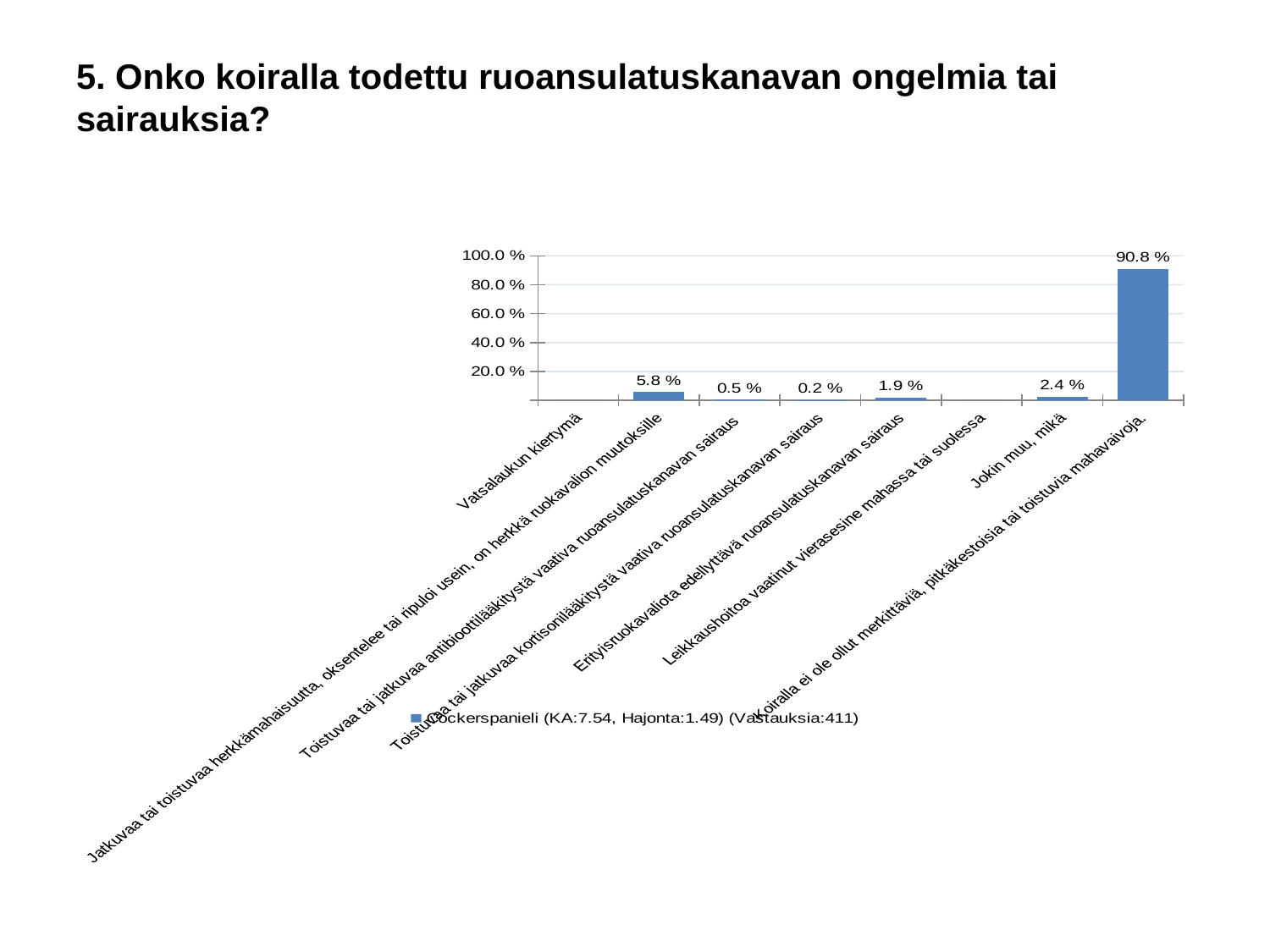
What series name does the legend show? Cockerspanieli (KA:7.54, Hajonta:1.49) (Vastauksia:411) What kind of chart is shown on the slide? bar chart What is the difference between the values for "Jokin muu, mikä" and "Erityisruokavaliota edellyttävä ruoansulatuskanavan sairaus"? 0.5 % What is the value for "Toistuvaa tai jatkuvaa kortisonilääkitystä vaativa ruoansulatuskanavan sairaus"? 0.2 % What is the value for "Jokin muu, mikä"? 2.4 % What is the value for "Koiralla ei ole ollut merkittäviä, pitkäkestoisia tai toistuvia mahavaivoja."? 90.8 % Which is larger, the value for "Jokin muu, mikä" or the value for "Toistuvaa tai jatkuvaa antibioottilääkitystä vaativa ruoansulatuskanavan sairaus"? Jokin muu, mikä Is the value for "Koiralla ei ole ollut merkittäviä, pitkäkestoisia tai toistuvia mahavaivoja." greater or less than 80.0 %? greater Which category has the highest value? Koiralla ei ole ollut merkittäviä, pitkäkestoisia tai toistuvia mahavaivoja. What is the value for "Erityisruokavaliota edellyttävä ruoansulatuskanavan sairaus"? 1.9 % How many categories are shown on the x axis? 8 What is the value for "Toistuvaa tai jatkuvaa antibioottilääkitystä vaativa ruoansulatuskanavan sairaus"? 0.5 %